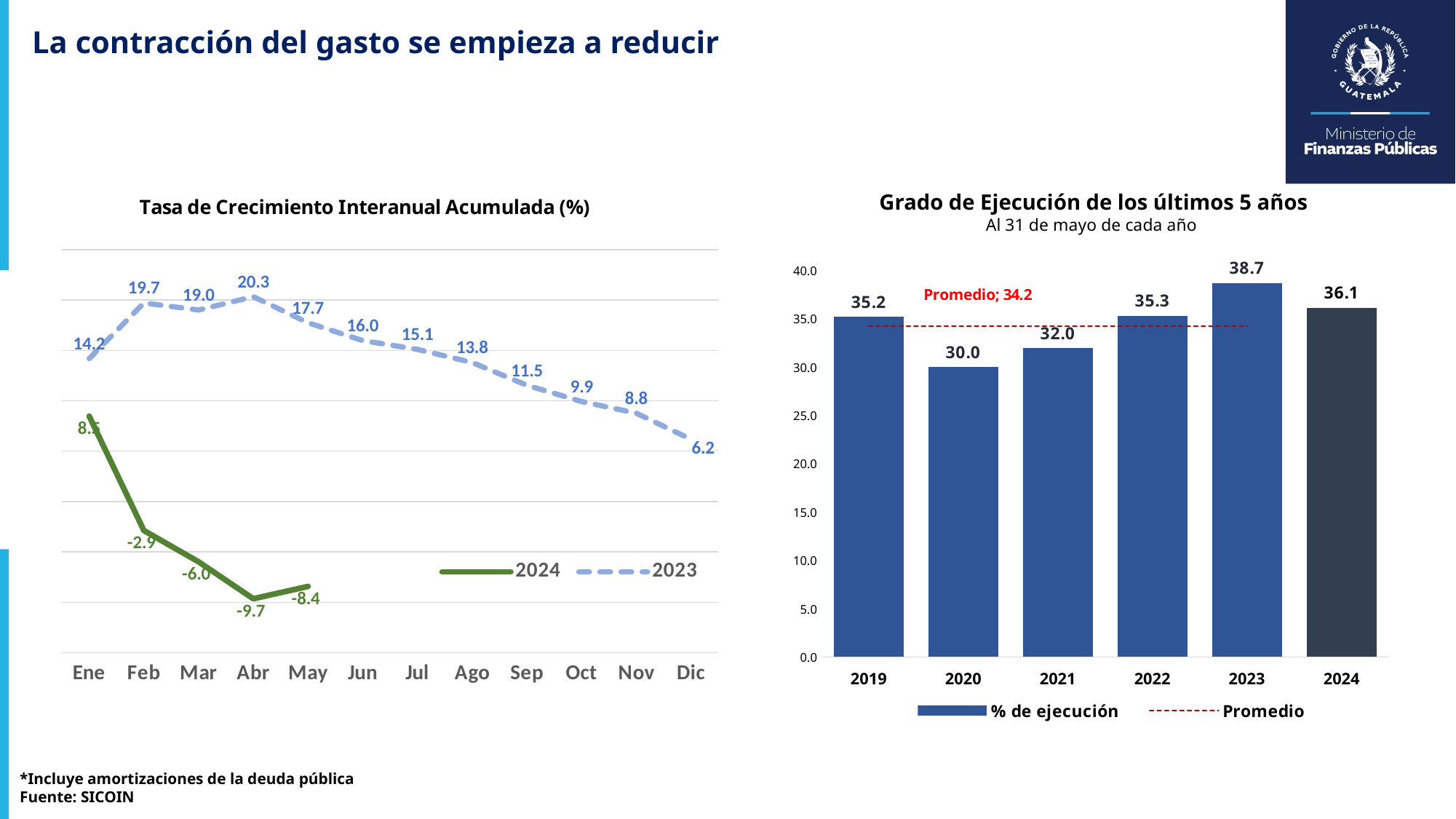
In the chart 'Tasa de Crecimiento Interanual Acumulada (%)', does the 2023 series rise or fall from Abr to Dic? fall In the chart 'Tasa de Crecimiento Interanual Acumulada (%)', what is the 2023 value for Dic? 6.2 In the chart 'Tasa de Crecimiento Interanual Acumulada (%)', what is the 2023 value for Abr? 20.3 What kind of chart is 'Grado de Ejecución de los últimos 5 años'? bar chart In the chart 'Tasa de Crecimiento Interanual Acumulada (%)', which month has the highest 2023 value? Abr In the chart 'Grado de Ejecución de los últimos 5 años', what is the difference between the values for 2023 and 2024? 2.6 In the chart 'Grado de Ejecución de los últimos 5 años', which year has the lowest value? 2020 In the chart 'Tasa de Crecimiento Interanual Acumulada (%)', what is the difference between the 2023 and 2024 values for May? 26.1 In the chart 'Grado de Ejecución de los últimos 5 años', what is the value for 2023? 38.7 In the chart 'Tasa de Crecimiento Interanual Acumulada (%)', what is the 2024 value for Abr? -9.7 In the chart 'Tasa de Crecimiento Interanual Acumulada (%)', how many series does the legend list? 2 In the chart 'Grado de Ejecución de los últimos 5 años', what is the value of the Promedio line? 34.2